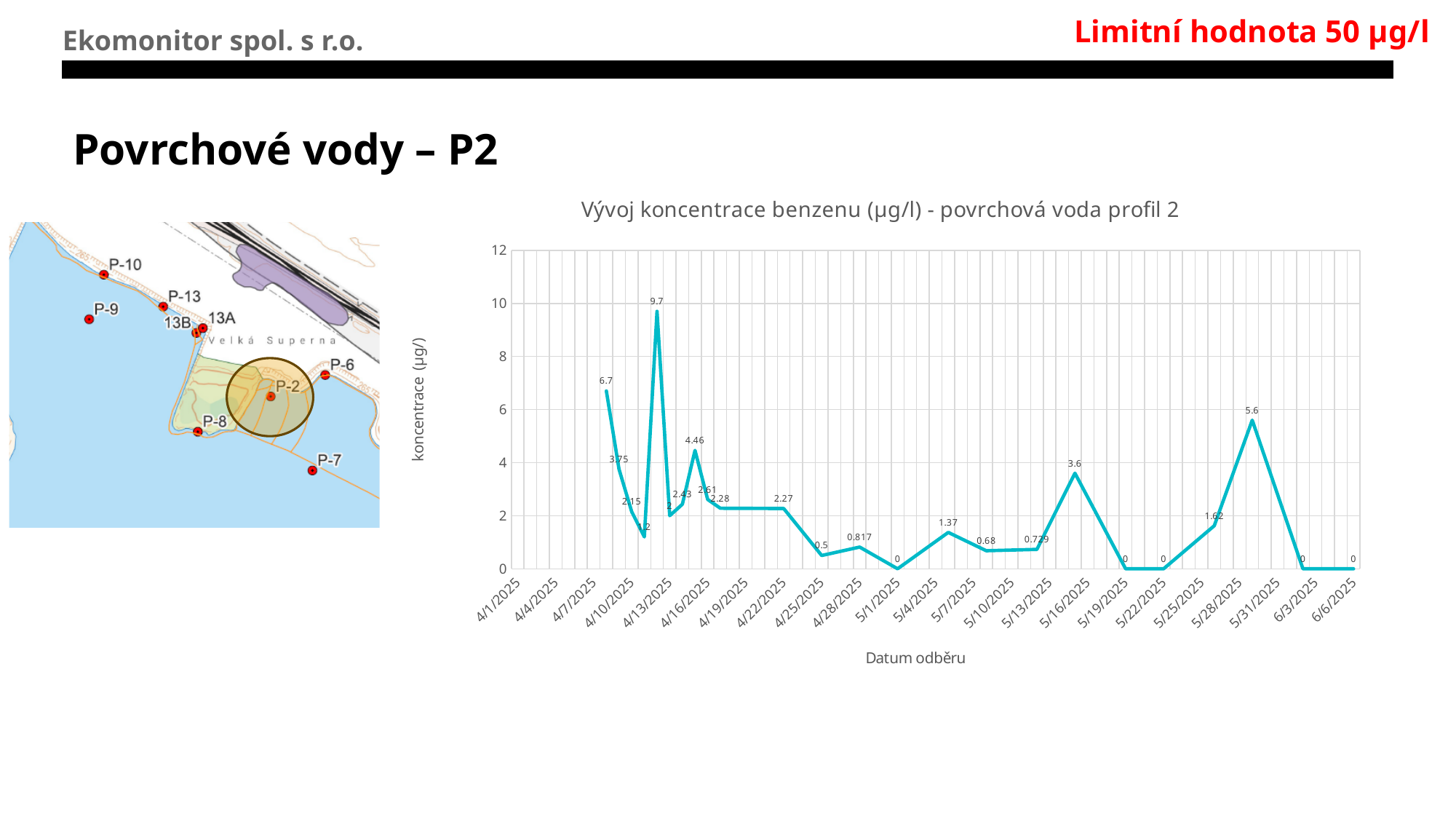
Overall, do the benzene concentration values rise or fall from the start of the period to the end? fall What type of chart is shown on the slide? line chart What is the value of the first data point on the chart (around 4/8/2025)? 6.7 What is the title of the chart? Vývoj koncentrace benzenu (µg/l) - povrchová voda profil 2 Is the highest peak on the chart greater or less than 8? greater What is the value of the peak near 5/28/2025? 5.6 What is the difference between the highest peak (9.7) and the peak near 5/28/2025 (5.6)? 4.1 Which is larger: the peak near 5/16/2025 or the peak near 5/28/2025? the peak near 5/28/2025 What is the value of the last data point on the chart (6/6/2025)? 0 What is the lowest benzene concentration value plotted on the chart? 0 What is the highest benzene concentration value plotted on the chart? 9.7 What is the label of the x axis of the chart? Datum odběru